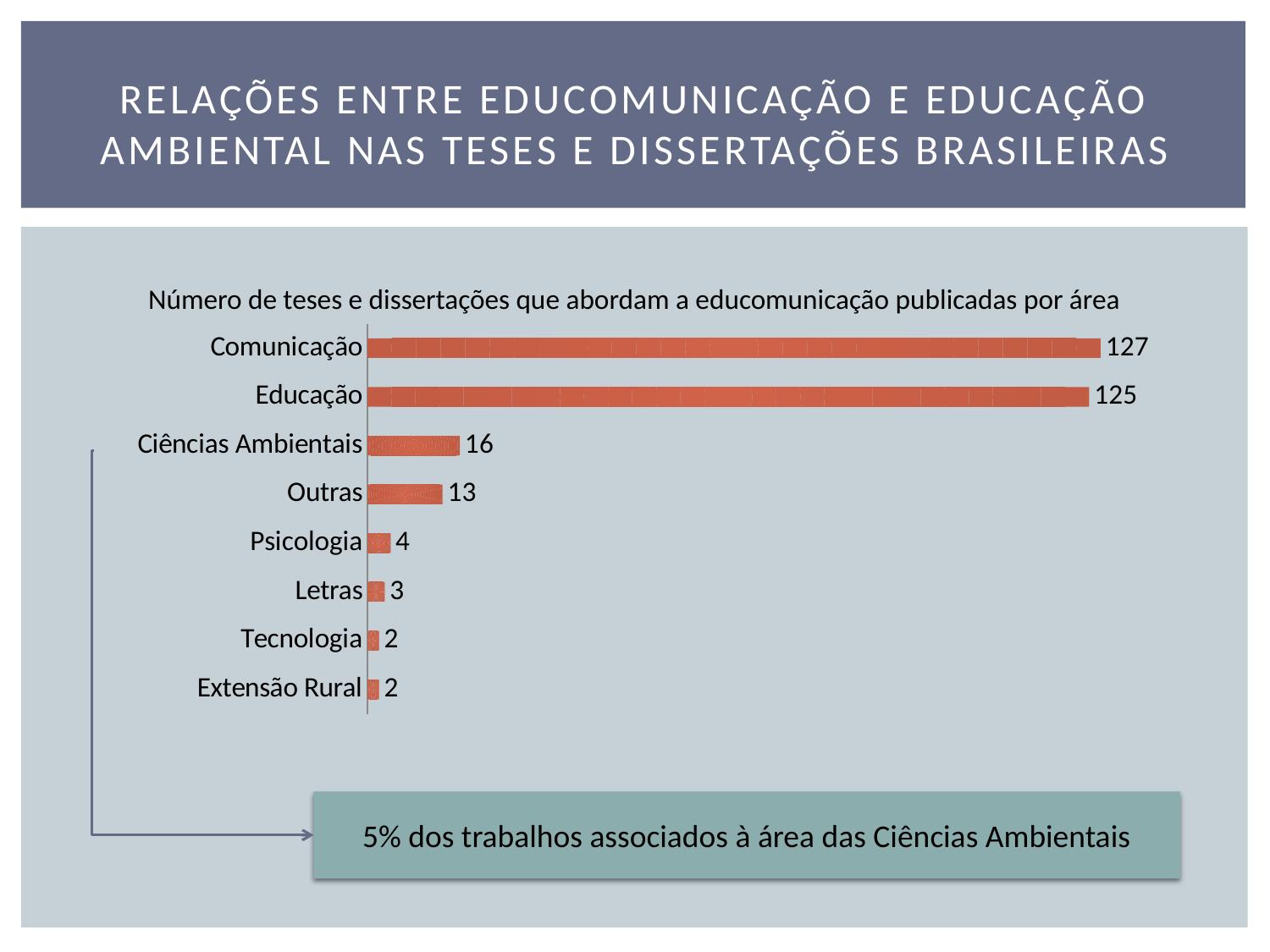
Which category has the lowest value among Letras, Psicologia and Outras? Letras What kind of chart is shown on the slide? Bar chart What is the difference between the values for Ciências Ambientais and Outras? 3 What is the value for Ciências Ambientais? 16 Which category has the highest value? Comunicação How many categories are shown in the chart? 8 What is the value for Psicologia? 4 Which is larger, the value for Outras or the value for Psicologia? Outras What is the total of the values for Tecnologia and Extensão Rural? 4 What is the value for Comunicação? 127 What is the difference between the values for Comunicação and Educação? 2 What is the title of the chart? Número de teses e dissertações que abordam a educomunicação publicadas por área